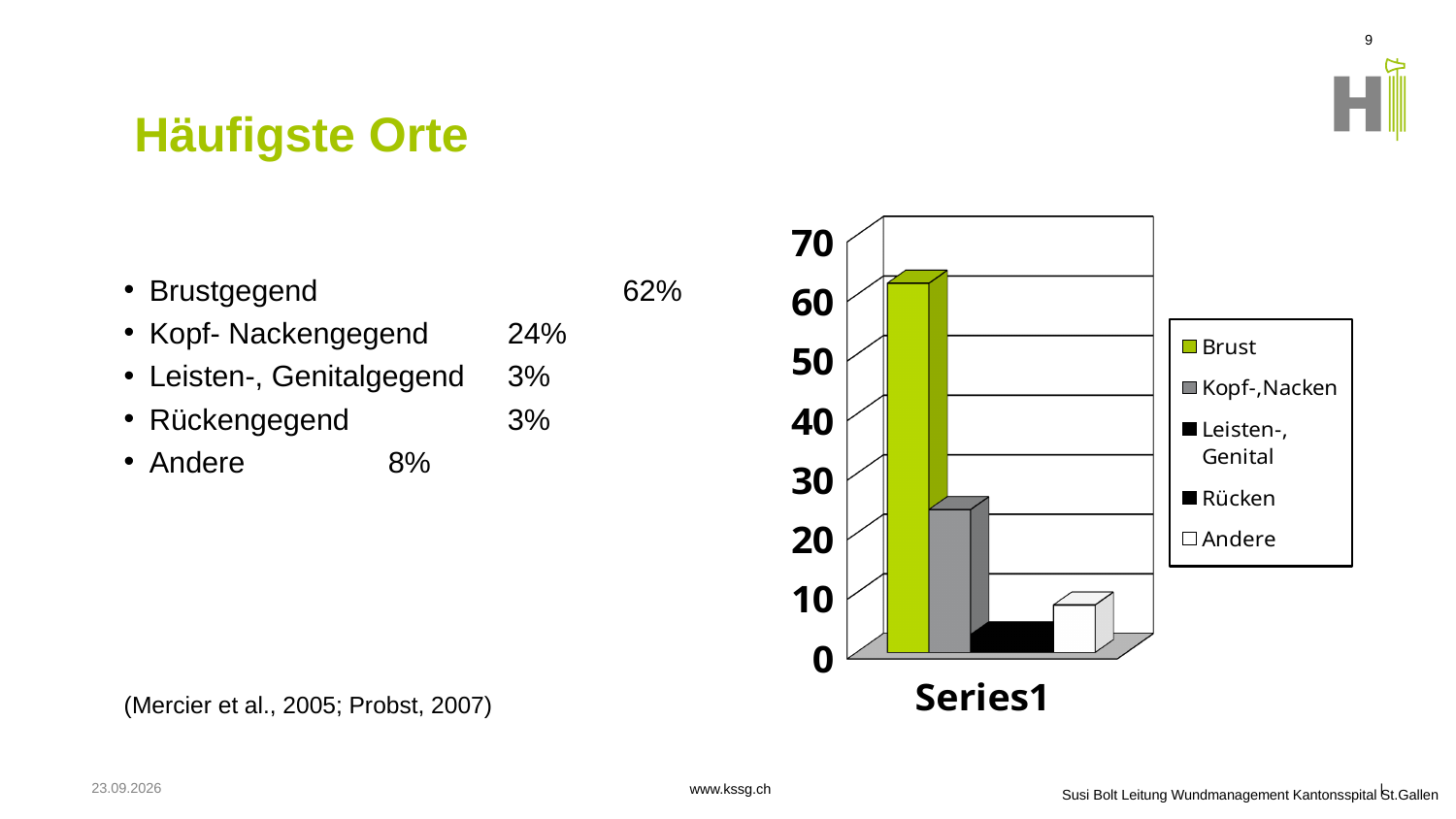
What kind of chart is shown on the slide? bar chart Which is larger in the chart, Kopf-,Nacken or Andere? Kopf-,Nacken Which series has the tallest bar in the chart? Brust Is the value for Rücken greater or less than 10? less How many series does the chart legend list? 5 What is the label shown on the x axis of the chart? Series1 What colour is the bar for Brust in the chart? green Is the value for Brust greater or less than 50? greater Which is larger in the chart, Brust or Kopf-,Nacken? Brust Which is larger in the chart, Andere or Rücken? Andere Is the value for Kopf-,Nacken greater or less than 30? less